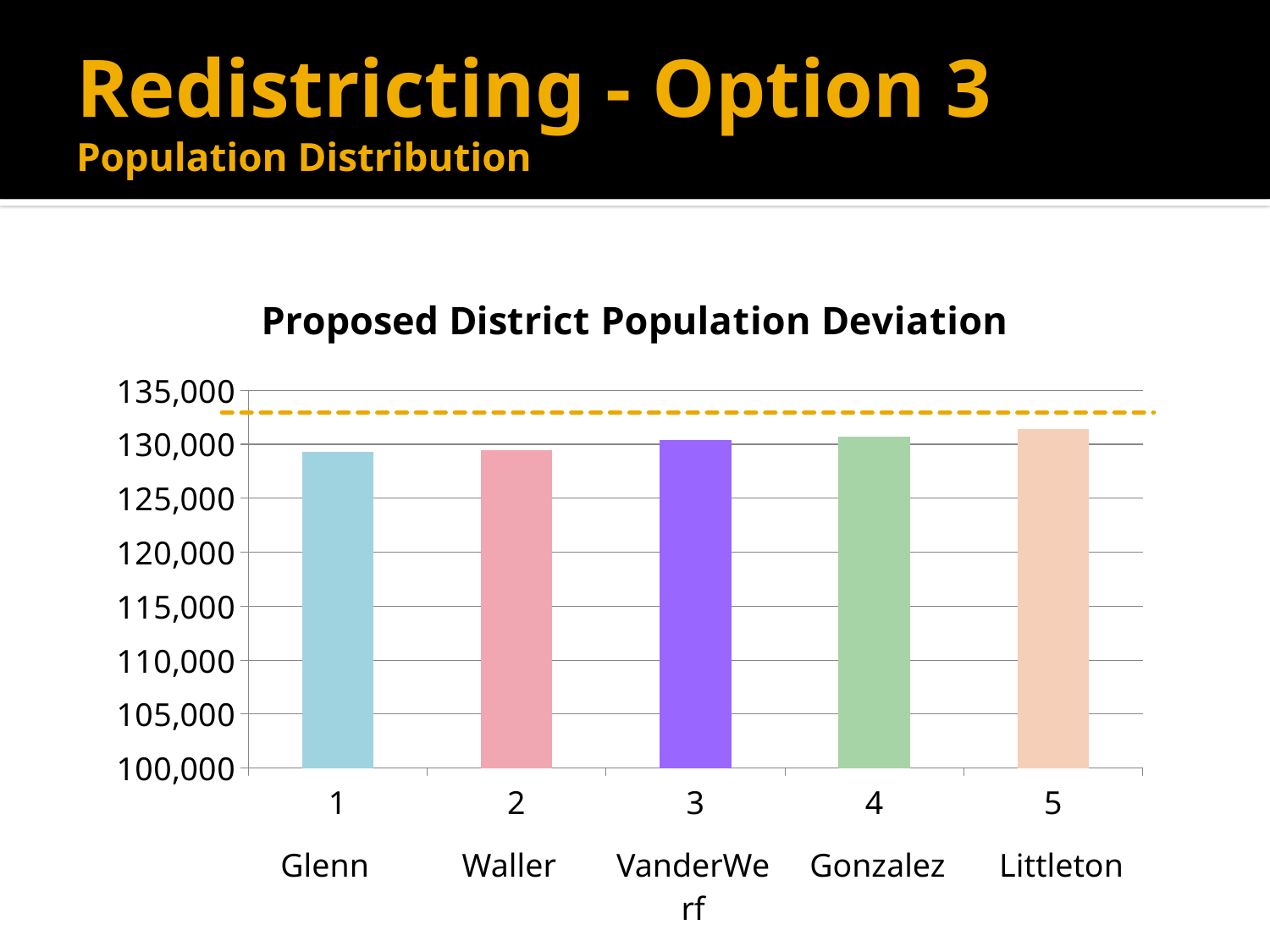
Which district has the highest population in the chart? Littleton What kind of chart is shown on the slide? bar chart What is the title of the chart? Proposed District Population Deviation Is the value for Gonzalez greater or less than 130,000? greater Which is larger, the value for Littleton or the value for Glenn? Littleton Is the value for Littleton greater or less than 130,000? greater How many districts (bars) are plotted in the chart? 5 What value does the vertical axis start at? 100,000 Which is larger, the value for VanderWerf or the value for Glenn? VanderWerf Is the value for Glenn greater or less than 130,000? less Do the bar values generally rise or fall from district 1 to district 5? rise